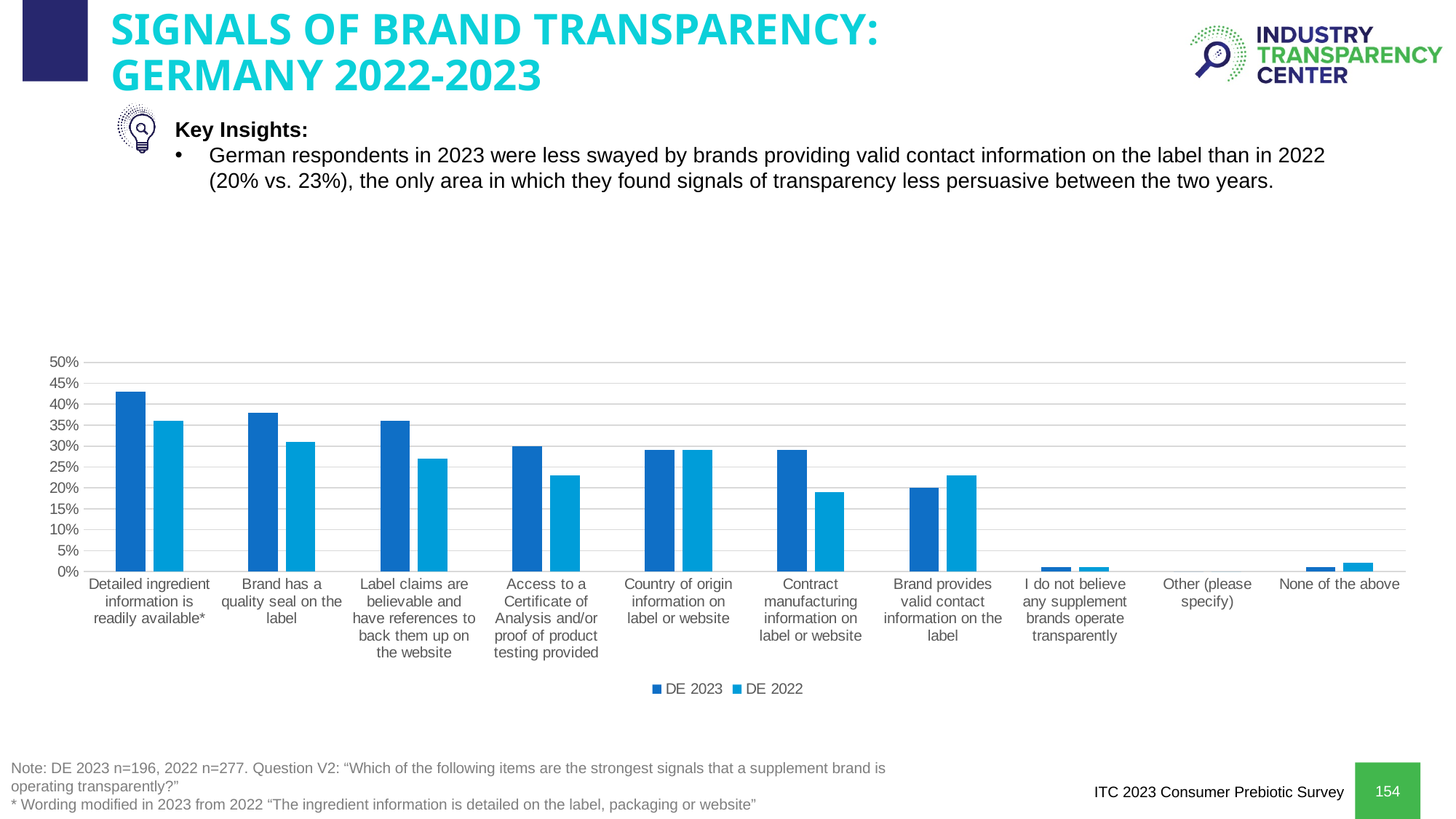
Is the DE 2022 value for 'Brand has a quality seal on the label' greater or less than 35%? less How many categories are shown along the x axis of the chart? 10 For 'Brand provides valid contact information on the label', which series has the larger value, DE 2023 or DE 2022? DE 2022 How many series does the legend list? 2 For 'Contract manufacturing information on label or website', which series has the larger value, DE 2023 or DE 2022? DE 2023 What kind of chart is shown on the slide? bar chart According to the slide, what was the DE 2022 value for 'Brand provides valid contact information on the label'? 23% Is the DE 2023 value for 'Detailed ingredient information is readily available*' greater or less than 40%? greater Which category has the highest DE 2023 value? Detailed ingredient information is readily available* What are the two legend entries of the chart? DE 2023 and DE 2022 Is the DE 2023 value for 'Other (please specify)' greater or less than 5%? less Which category has the highest DE 2022 value? Detailed ingredient information is readily available*